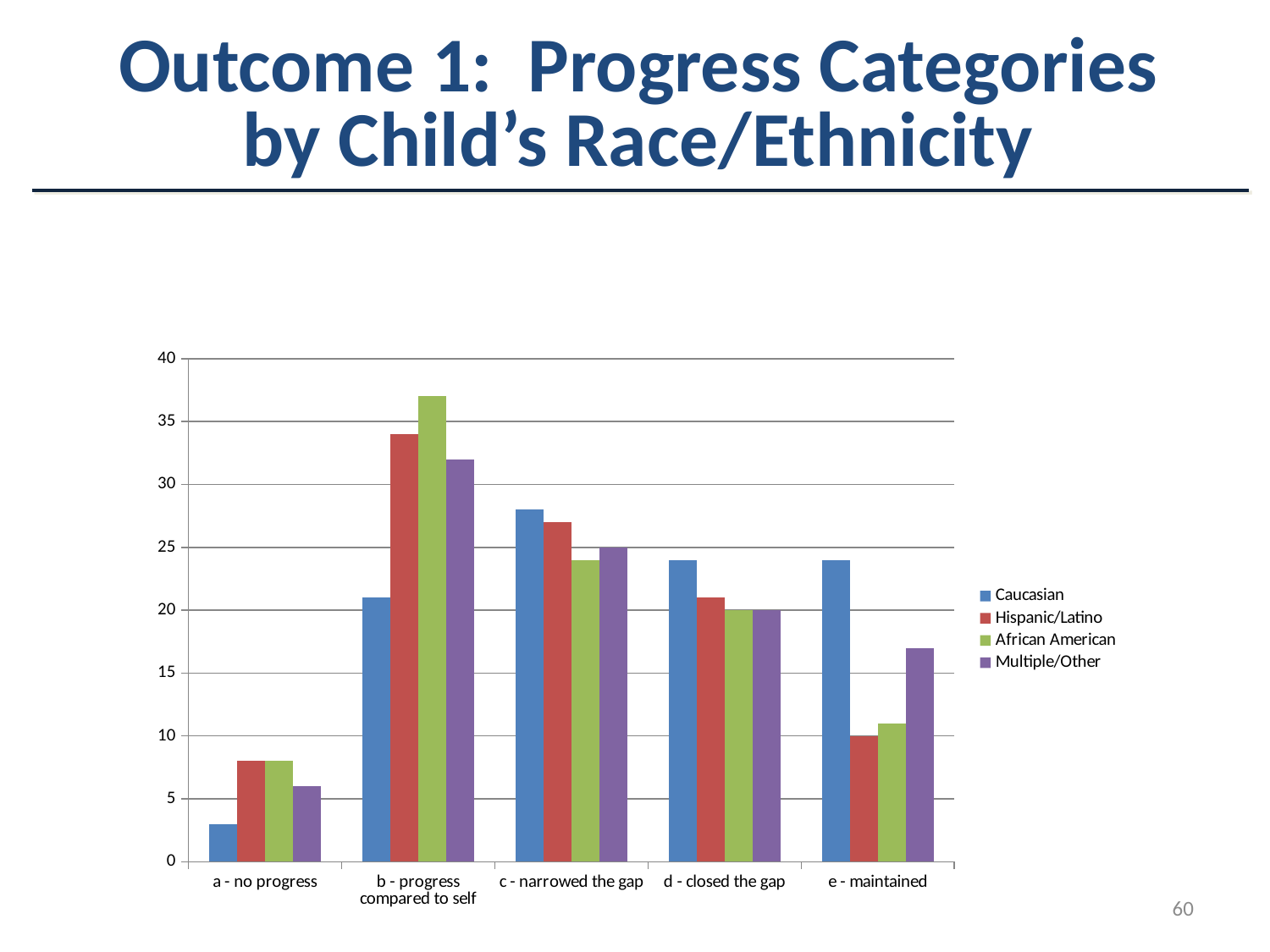
What kind of chart is shown on the slide? bar chart Which progress category has the lowest value for Caucasian? a - no progress Is the value for African American in 'b - progress compared to self' greater or less than 35? greater In the 'c - narrowed the gap' category, which is larger: Caucasian or African American? Caucasian Which series has the highest value in the 'b - progress compared to self' category? African American How many series does the legend list? 4 Which series has the lowest value in the 'e - maintained' category? Hispanic/Latino Is the value for Multiple/Other in 'e - maintained' greater or less than 15? greater Which progress category has the highest value for African American? b - progress compared to self Which series is shown in purple in the legend? Multiple/Other How many progress categories are shown on the x axis? 5 Is the value for Caucasian in 'a - no progress' greater or less than 5? less